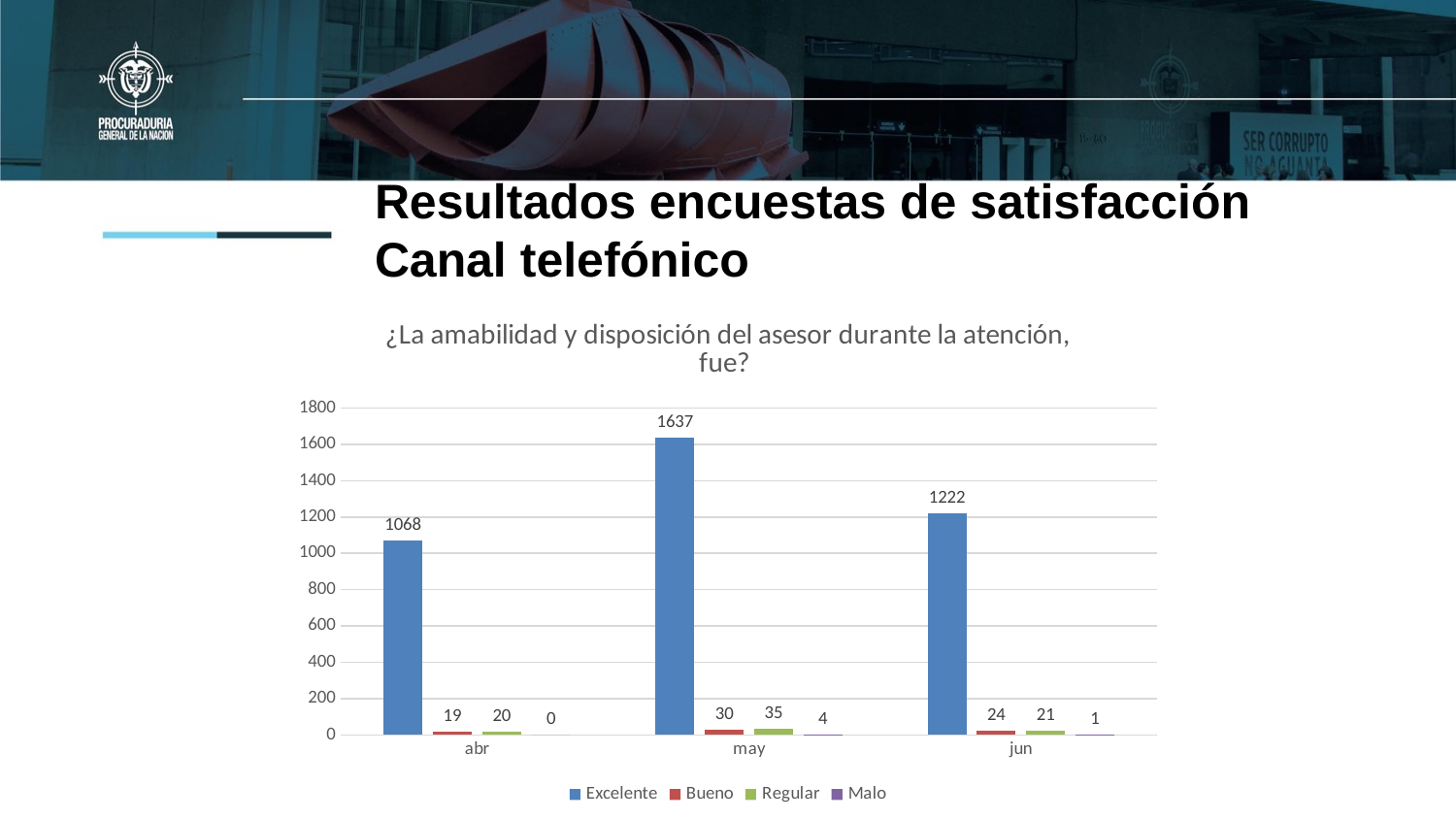
What kind of chart is shown on the slide? bar chart What is the value for Malo in jun? 1 How many series does the legend list? 4 What is the title of the chart? ¿La amabilidad y disposición del asesor durante la atención, fue? What is the value for Excelente in may? 1637 Which is larger, the Bueno value in jun or the Regular value in jun? Bueno In which month is the Excelente value highest? may What is the difference between the Excelente values for may and jun? 415 What is the value for Bueno in may? 30 How many months are shown on the x axis? 3 In which month is the Excelente value lowest? abr What is the value for Regular in abr? 20